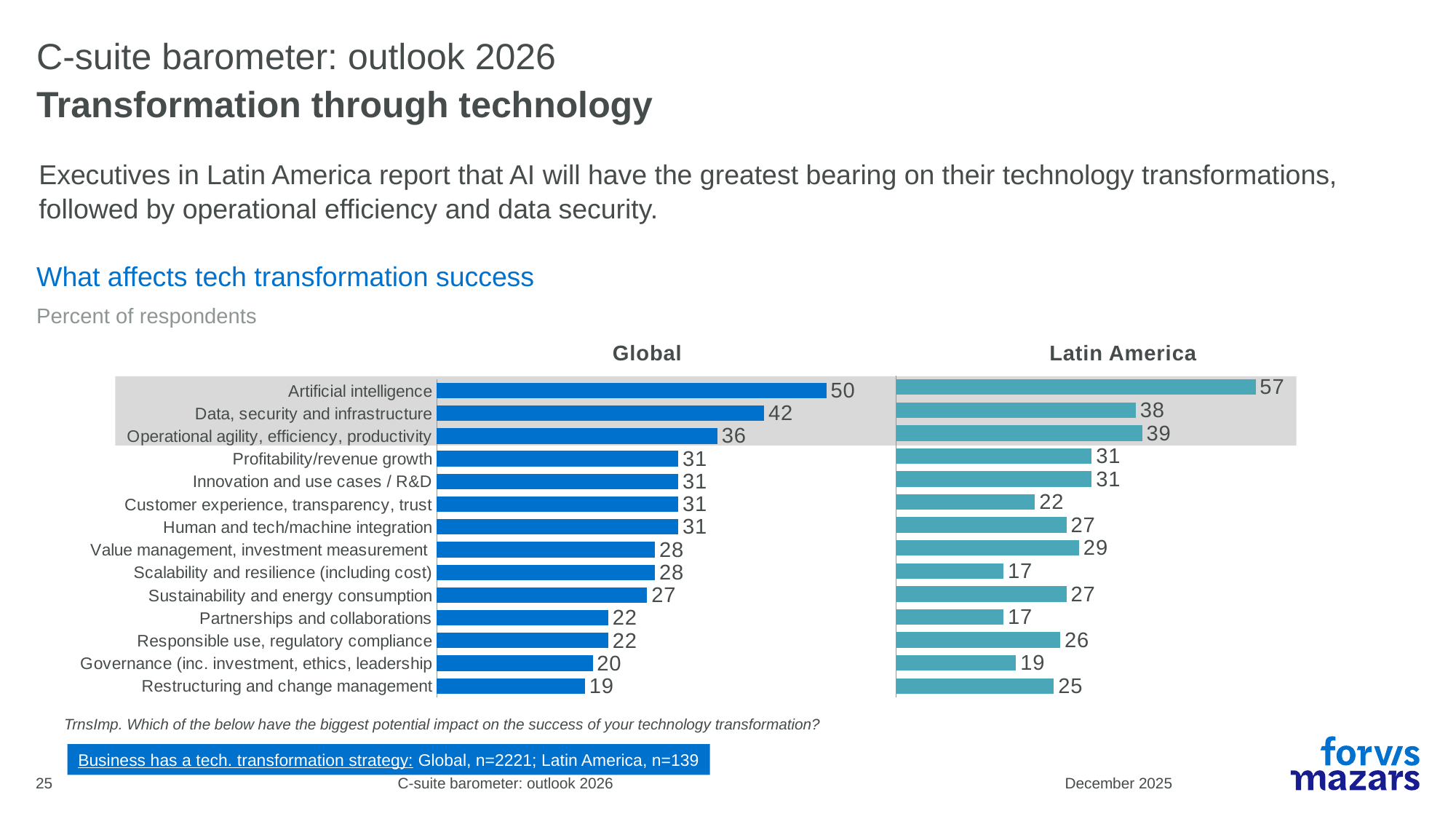
In the Global chart, which category has the lowest value? Restructuring and change management In the Latin America chart, which category has the highest value? Artificial intelligence In the Global chart, what is the value for Artificial intelligence? 50 What is the difference between the Latin America and Global values for Artificial intelligence? 7 What is the title of the chart section on the slide? What affects tech transformation success How many categories are listed in the charts? 14 In the Latin America chart, what is the value for Data, security and infrastructure? 38 What kind of chart is used on this slide? Bar chart In the Global chart, which category has the highest value? Artificial intelligence In the Global chart, what is the difference between Data, security and infrastructure and Operational agility, efficiency, productivity? 6 In the Latin America chart, what is the value for Restructuring and change management? 25 Which is larger for Scalability and resilience (including cost): the Global value or the Latin America value? Global